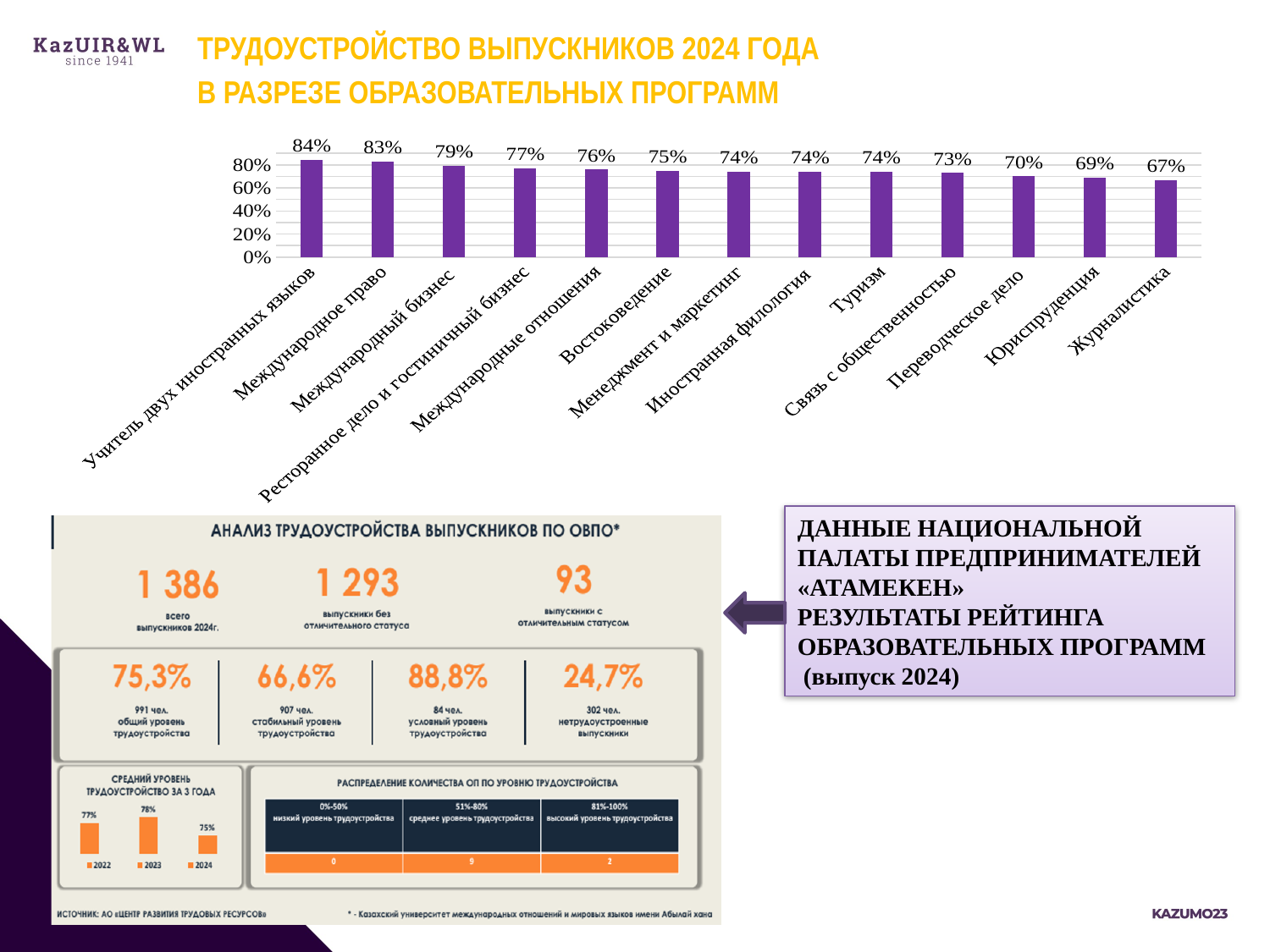
In the bar chart at the top of the slide, which category has the highest value? Учитель двух иностранных языков In the small chart titled 'Средний уровень трудоустройство за 3 года' at the bottom left, which year has the lowest value? 2024 In the bar chart at the top of the slide, which is larger: the value for Международный бизнес or the value for Переводческое дело? Международный бизнес In the bar chart at the top of the slide, what is the value for Туризм? 74% In the bar chart at the top of the slide, what is the value for Международное право? 83% In the bar chart at the top of the slide, what is the value for Журналистика? 67% In the bar chart at the top of the slide, what is the difference between the values for Учитель двух иностранных языков and Журналистика? 17% In the bar chart at the top of the slide, how many categories are shown? 13 In the bar chart at the top of the slide, which category has the lowest value? Журналистика In the small chart titled 'Средний уровень трудоустройство за 3 года' at the bottom left, what is the value for 2023? 78% What kind of chart is shown at the top of the slide? Bar chart In the bar chart at the top of the slide, do the values rise or fall from left to right? Fall